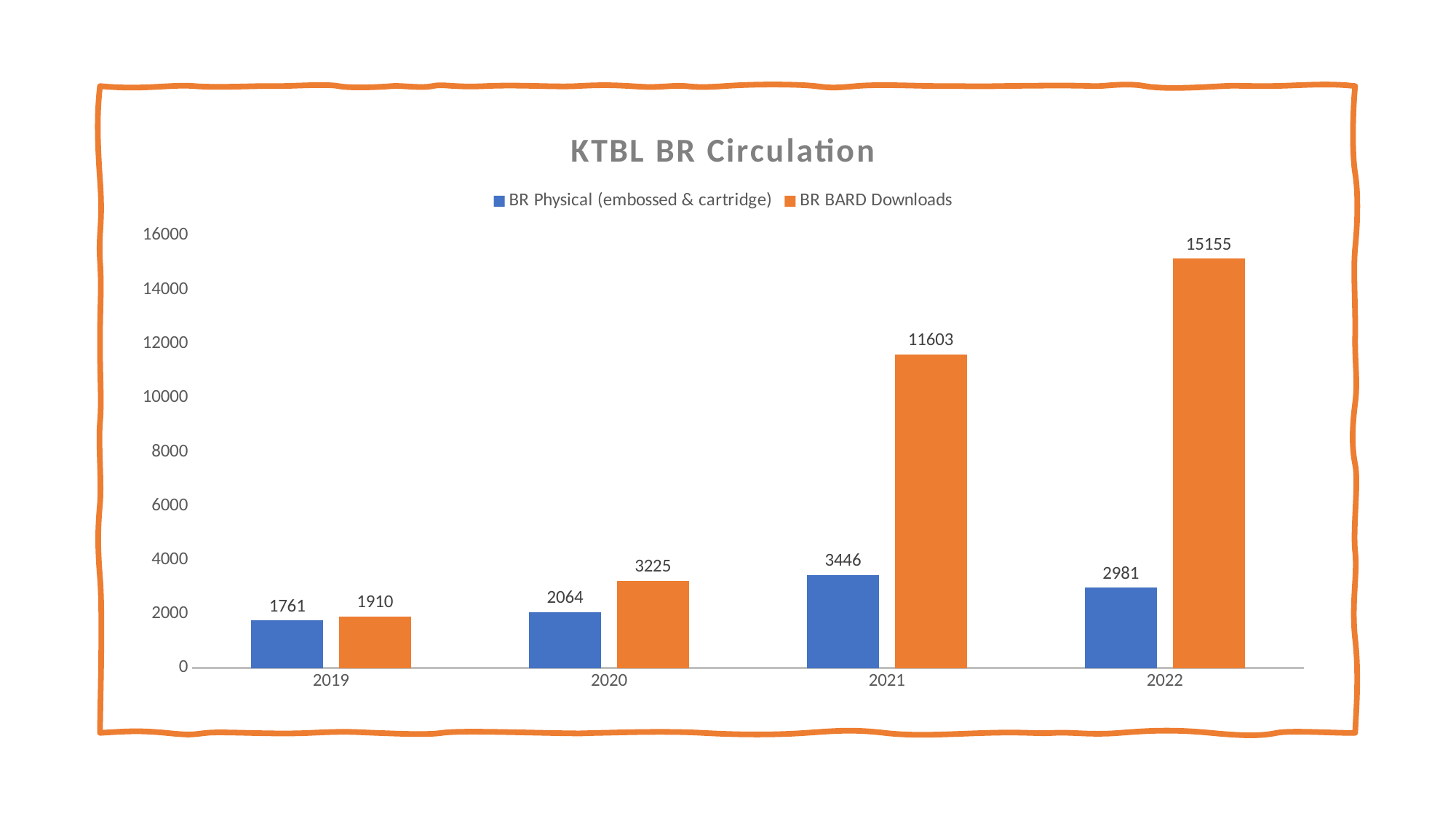
Which is larger in 2022: BR Physical (embossed & cartridge) or BR BARD Downloads? BR BARD Downloads How many series does the legend list? 2 What is the value for BR BARD Downloads in 2022? 15155 Is the value for BR BARD Downloads in 2021 greater or less than 10000? greater In which year is BR BARD Downloads lowest? 2019 How many years are shown on the x axis? 4 Do the BR BARD Downloads values rise or fall from 2019 to 2022? rise What is the difference between BR BARD Downloads and BR Physical (embossed & cartridge) in 2021? 8157 What kind of chart is shown? bar chart In which year is BR Physical (embossed & cartridge) highest? 2021 What is the value for BR Physical (embossed & cartridge) in 2020? 2064 What is the value for BR BARD Downloads in 2019? 1910